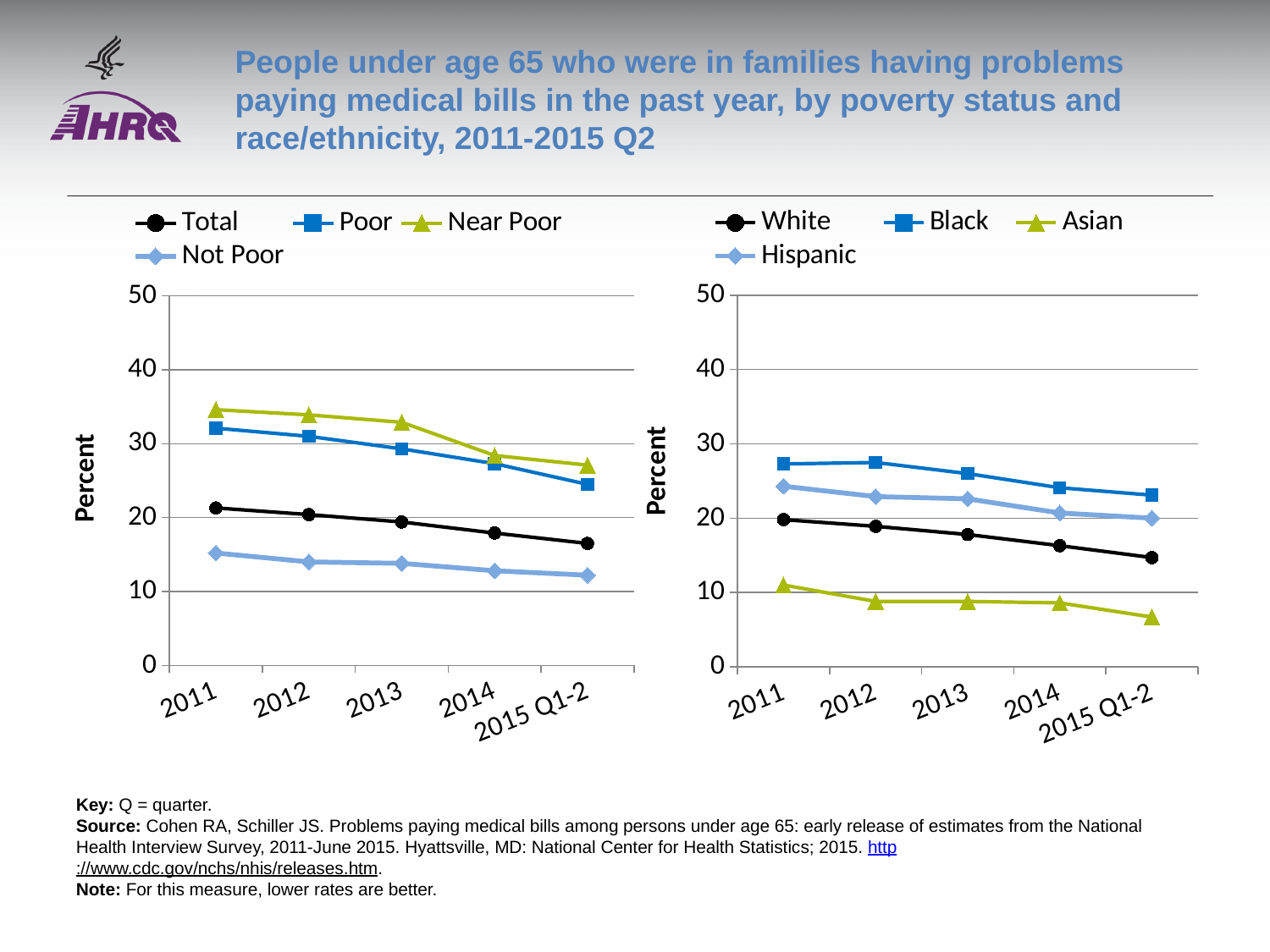
How many series does the legend of the right chart (by race/ethnicity) list? 4 In the left chart (by poverty status), does the Near Poor line rise or fall from 2011 to 2015 Q1-2? Fall In the left chart (by poverty status), which series has the highest value in 2011? Near Poor How many time points are shown on the x axis of the right chart (by race/ethnicity)? 5 How many series does the legend of the left chart (by poverty status) list? 4 In the left chart (by poverty status), is the value for Poor in 2011 greater or less than 30? greater What kind of chart is the left chart (by poverty status)? Line chart In the right chart (by race/ethnicity), which is larger in 2011, the value for Black or the value for Hispanic? Black In the right chart (by race/ethnicity), does the White line rise or fall from 2011 to 2015 Q1-2? Fall In the right chart (by race/ethnicity), is the value for Asian in 2015 Q1-2 greater or less than 10? less What are the legend entries of the right chart (by race/ethnicity)? White, Black, Asian, Hispanic In the right chart (by race/ethnicity), which series has the lowest value in 2011? Asian